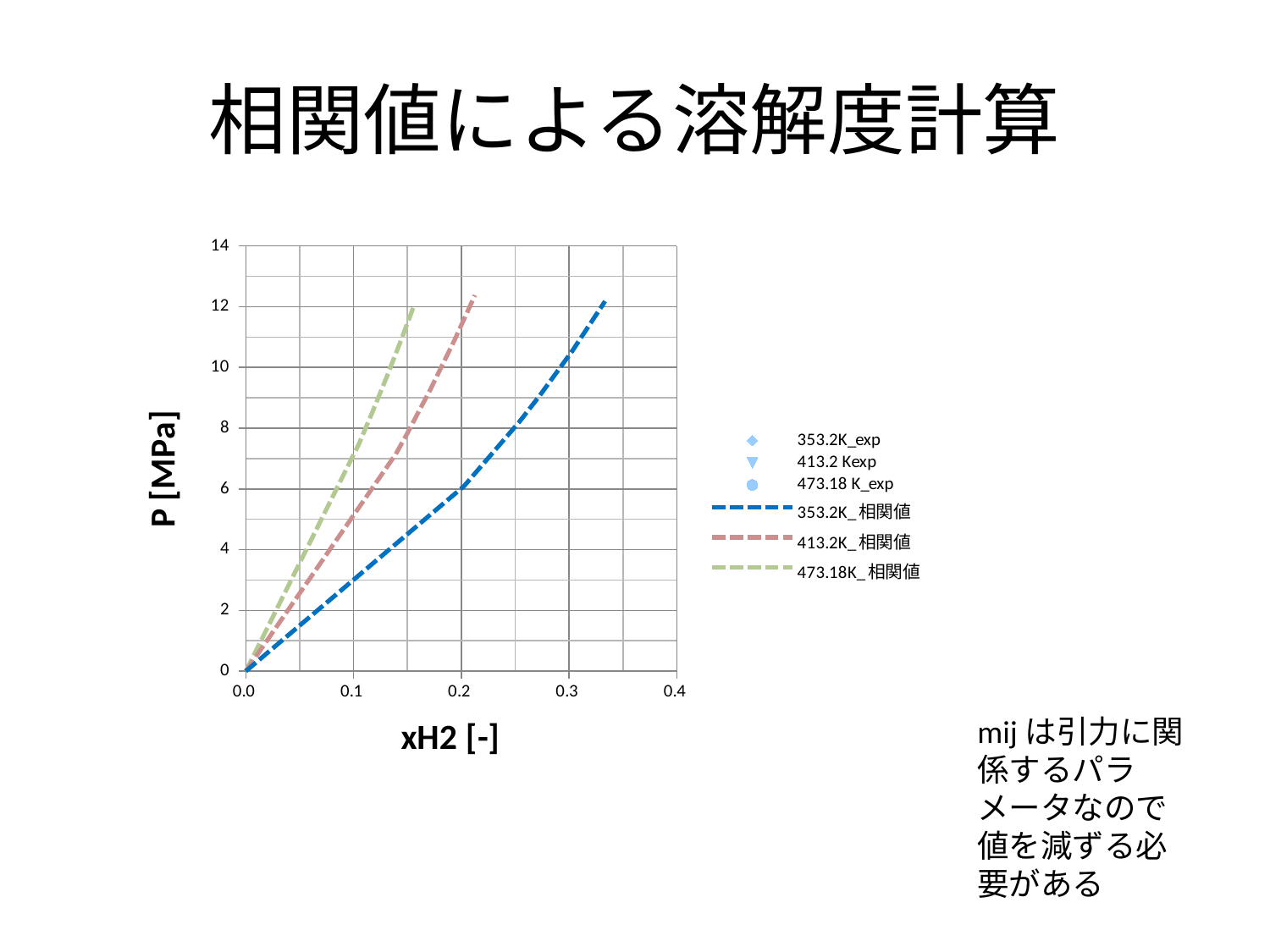
How many entries does the chart's legend list? 6 At xH2 = 0.3, is the value of the 353.2K_相関値 line greater or less than 8 MPa? greater How many dashed correlation lines are plotted on the chart? 3 At xH2 = 0.1, which line has the higher P value, 353.2K_相関値 or 473.18K_相関値? 473.18K_相関値 What kind of chart is shown on the slide? line chart Does the 353.2K_相関値 line rise or fall as xH2 increases? rise At xH2 = 0.1, is the value of the 353.2K_相関値 line greater or less than 4 MPa? less Which correlation line extends to the largest xH2 value? 353.2K_相関値 At xH2 = 0.1, is the value of the 473.18K_相関値 line greater or less than 6 MPa? greater What is the title of the vertical axis of the chart? P [MPa] What is the title of the horizontal axis of the chart? xH2 [-]